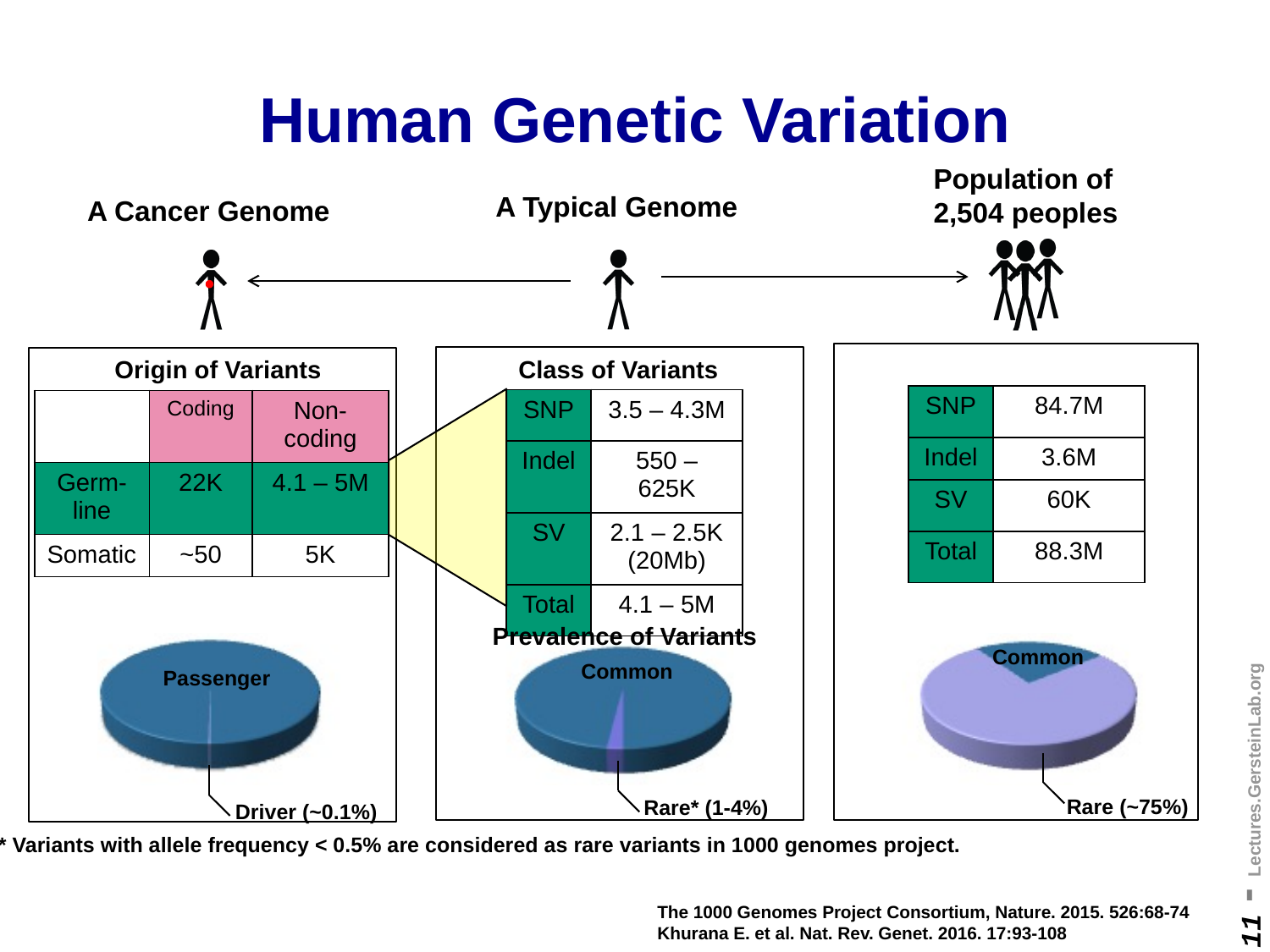
How many pie charts are on the slide? 3 In the "A Typical Genome" pie chart, which slice is the smallest? Rare* In the "A Cancer Genome" pie chart, which slice is larger, Passenger or Driver? Passenger Which pie chart on the slide has Rare as its larger slice? Population of 2,504 peoples In the "Population of 2,504 peoples" pie chart, which slice is smaller, Common or Rare? Common What kind of chart is shown under "A Cancer Genome"? Pie chart In the "Population of 2,504 peoples" pie chart, how many slices are there? 2 In the "A Cancer Genome" pie chart, how many slices are there? 2 What are the two slice labels in the "A Typical Genome" pie chart? Common and Rare* In the "Population of 2,504 peoples" pie chart, which slice is the largest? Rare In the "A Typical Genome" pie chart, which slice is larger, Common or Rare*? Common